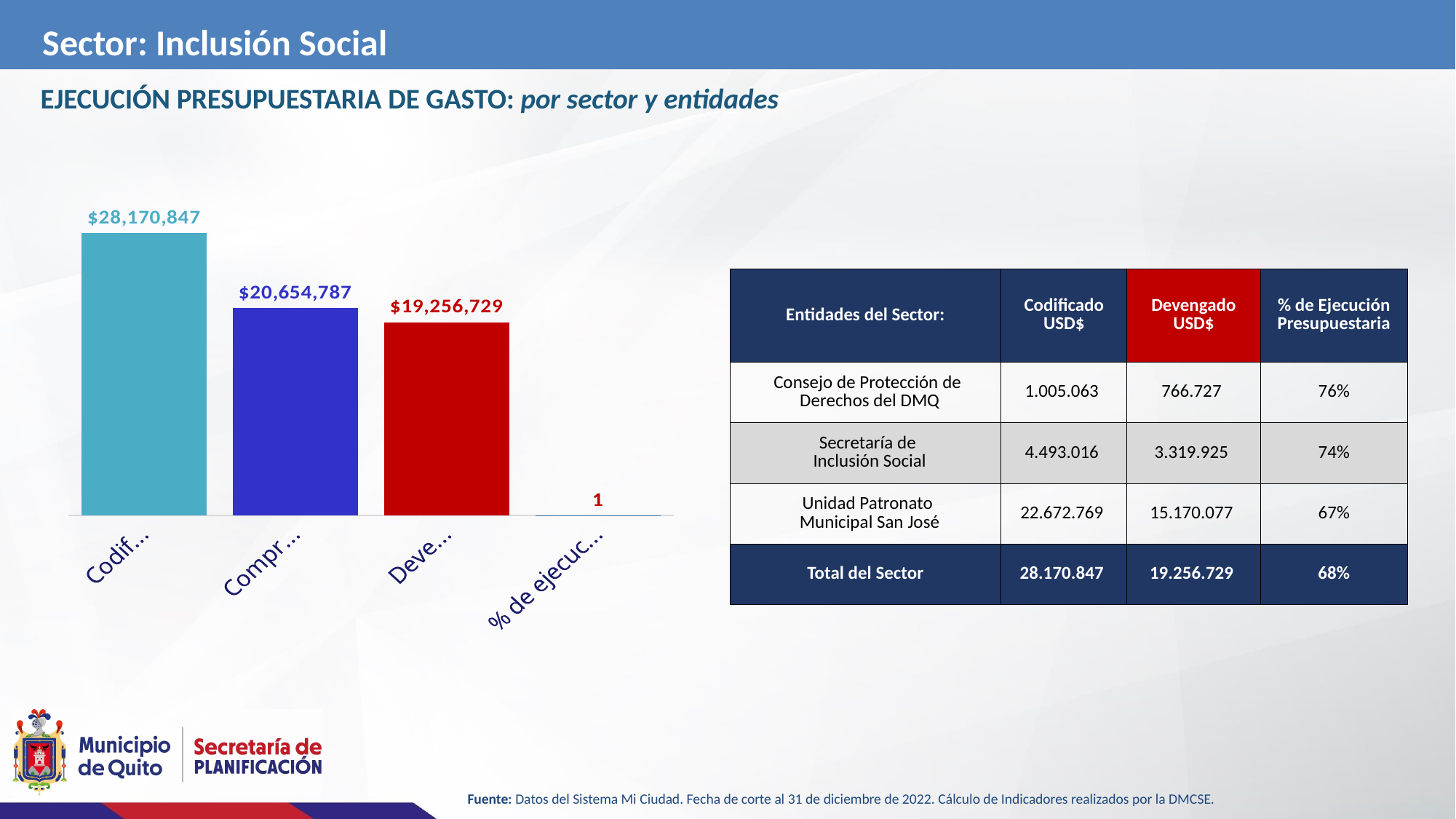
Which bar has the lowest value? % de ejecuc... What value is labelled on the second (blue) bar, "Compr..."? $20,654,787 What is the difference between the "Codif..." bar and the "Deve..." bar? $8,914,118 Which bar has the highest value? Codif... Which is larger, the "Compr..." bar or the "Deve..." bar? Compr... What value is labelled on the last bar, "% de ejecuc..."? 1 What is the difference between the "Compr..." bar and the "Deve..." bar? $1,398,058 What type of chart is shown on the slide? bar chart What colour is the "Deve..." bar? red What value is labelled on the third (red) bar, "Deve..."? $19,256,729 What value is labelled on the first (teal) bar, "Codif..."? $28,170,847 How many bars (categories) does the chart show? 4